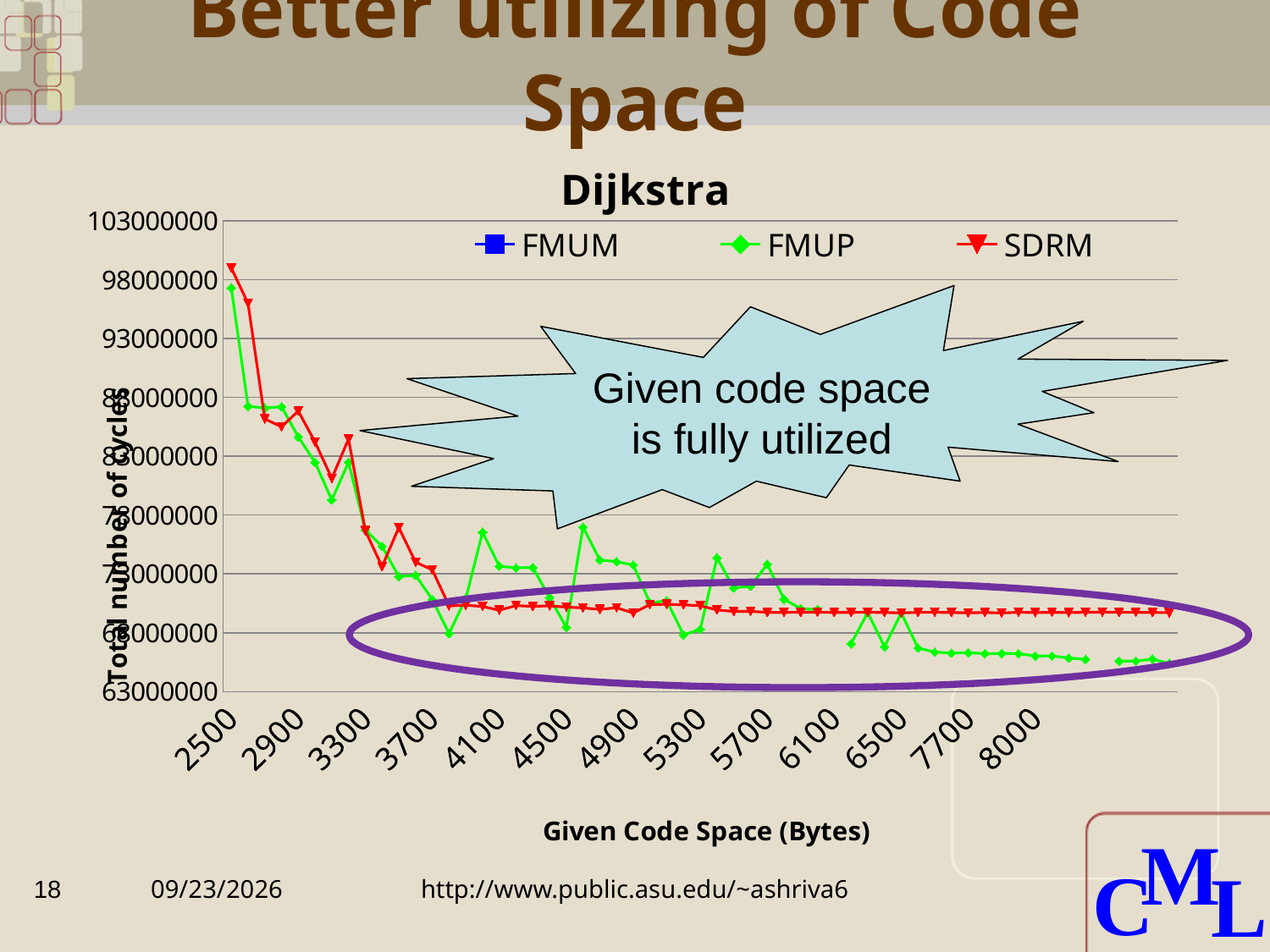
What is the title of the chart? Dijkstra What is the x-axis title of the chart? Given Code Space (Bytes) At 8000 bytes, which series has the larger value, SDRM or FMUP? SDRM Is the value for SDRM at 2500 bytes greater or less than 98000000? greater Do the values of the SDRM series rise or fall overall as the given code space increases? fall How many tick labels are shown on the x axis of the chart? 13 Is the value for FMUP at 8000 bytes greater or less than 68000000? less At 2500 bytes, which series has the larger value, SDRM or FMUP? SDRM How many series does the legend of the Dijkstra chart list? 3 What kind of chart is shown on the slide? line chart Which series is drawn in red in the Dijkstra chart? SDRM Is the value for SDRM at 8000 bytes greater or less than 68000000? greater